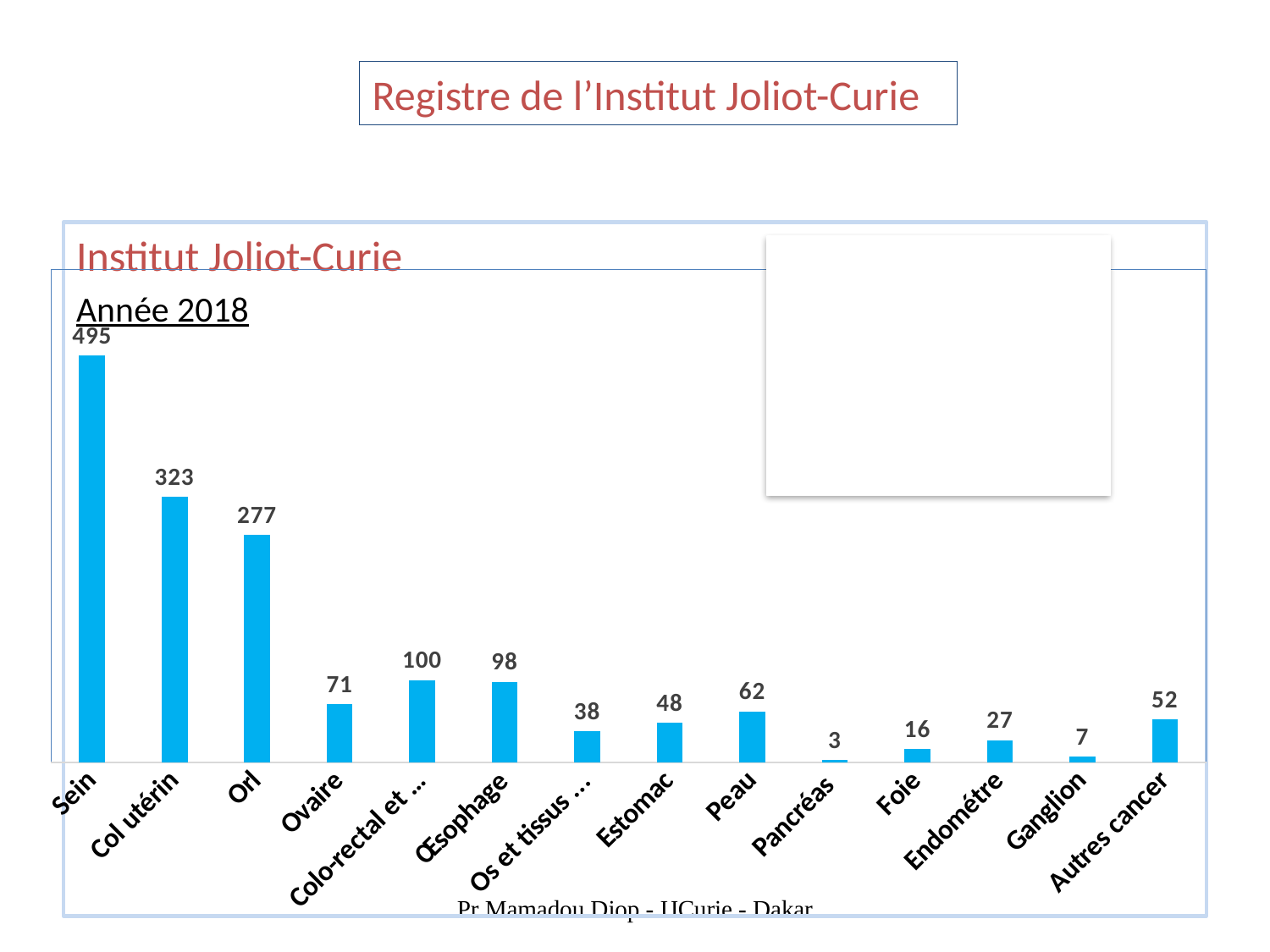
Which category has the highest value? Sein What kind of chart is shown on the slide? Bar chart What is the value for Autres cancer? 52 What is the value for Sein? 495 Which is larger, the value for Peau or the value for Estomac? Peau What is the value for Col utérin? 323 What is the value for Œsophage? 98 Which category has the lowest value? Pancréas What is the difference between the values for Orl and Ovaire? 206 What is the difference between the values for Sein and Col utérin? 172 How many categories are shown on the x axis? 14